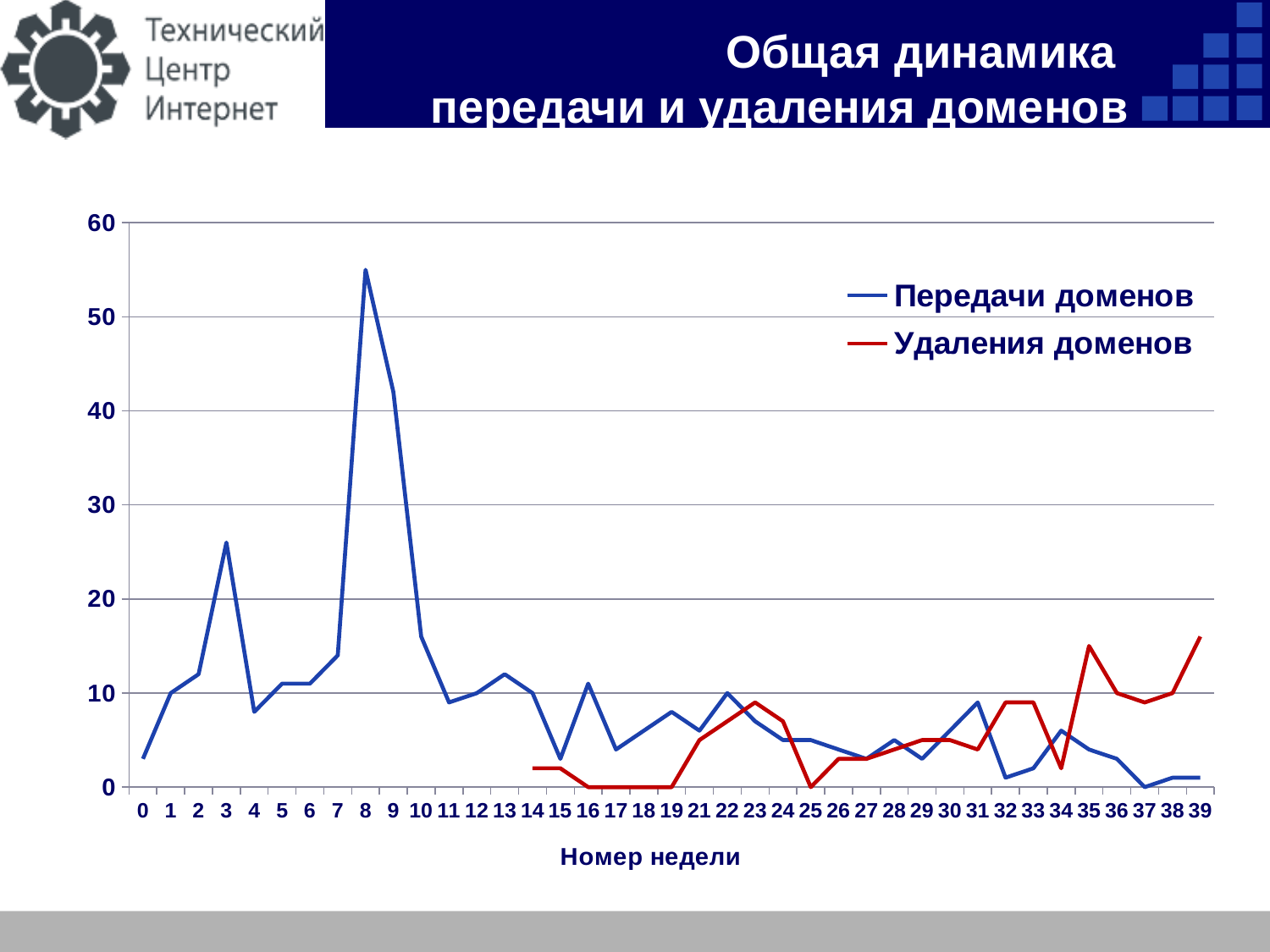
Does the Передачи доменов series rise or fall from week 8 to week 11? fall How many series does the legend list? 2 At week 39, which series has the larger value, Передачи доменов or Удаления доменов? Удаления доменов What kind of chart is shown on the slide? line chart Is the value for Удаления доменов at week 35 greater or less than 10? greater At week 32, which series has the larger value, Передачи доменов or Удаления доменов? Удаления доменов Is the value for Передачи доменов at week 10 greater or less than 20? less At which week number does the Передачи доменов series reach its highest value? 8 What is the title of the x axis? Номер недели Is the value for Передачи доменов at week 8 greater or less than 50? greater